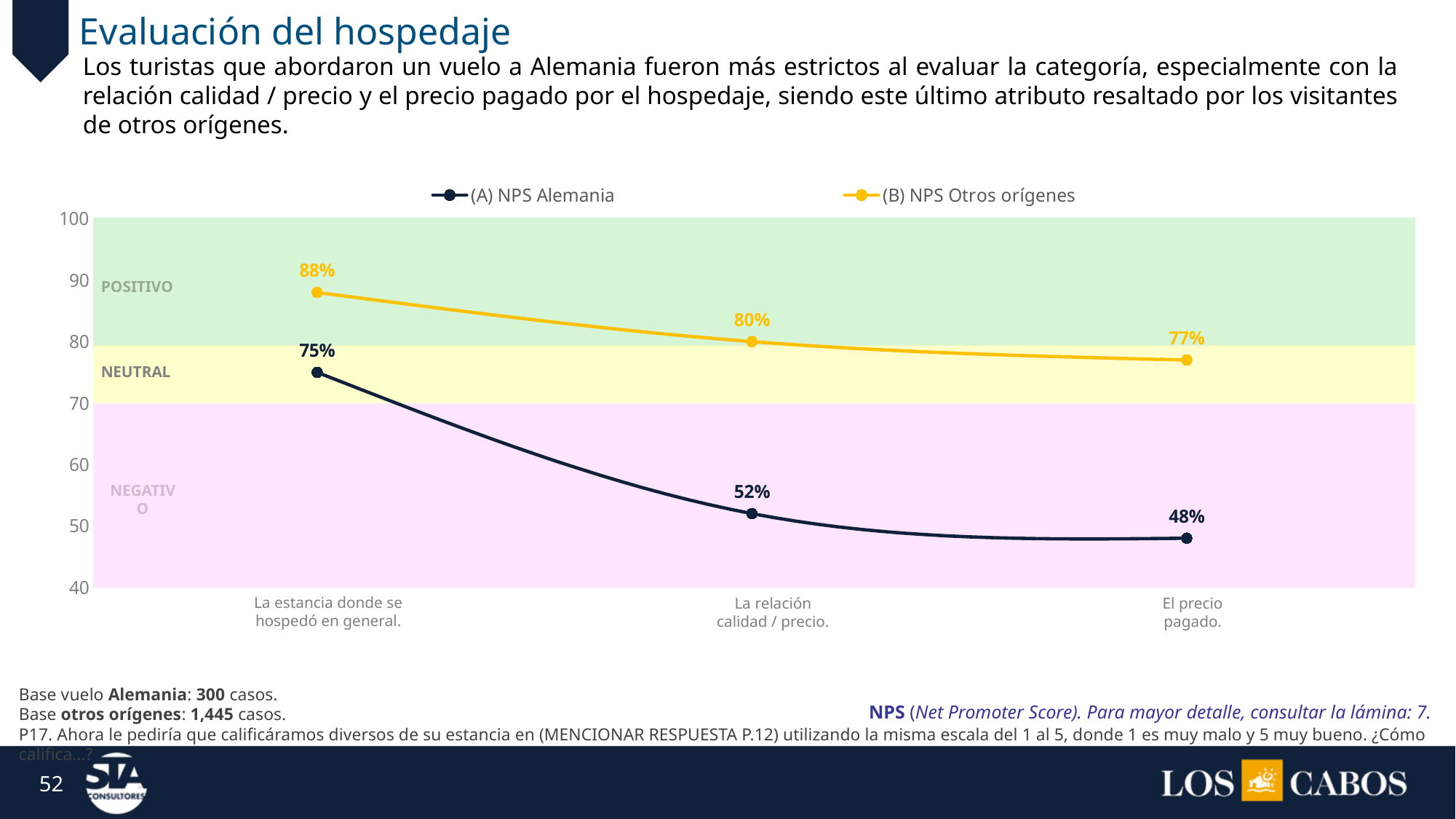
What is the NPS Alemania value for 'La estancia donde se hospedó en general'? 75% What kind of chart is shown on the slide? line chart Which category has the lowest NPS Alemania value? El precio pagado. What is the NPS Otros orígenes value for 'El precio pagado'? 77% What is the NPS Alemania value for 'La relación calidad / precio'? 52% Do the NPS Alemania values rise or fall from left to right along the x axis? fall How many categories are shown on the x axis? 3 How many series does the legend list? 2 Is the NPS Alemania value for 'La relación calidad / precio' greater or less than 60? less Which is larger for 'La relación calidad / precio': NPS Alemania or NPS Otros orígenes? NPS Otros orígenes Which category has the highest NPS Otros orígenes value? La estancia donde se hospedó en general. What is the difference between NPS Otros orígenes and NPS Alemania for 'El precio pagado'? 29%